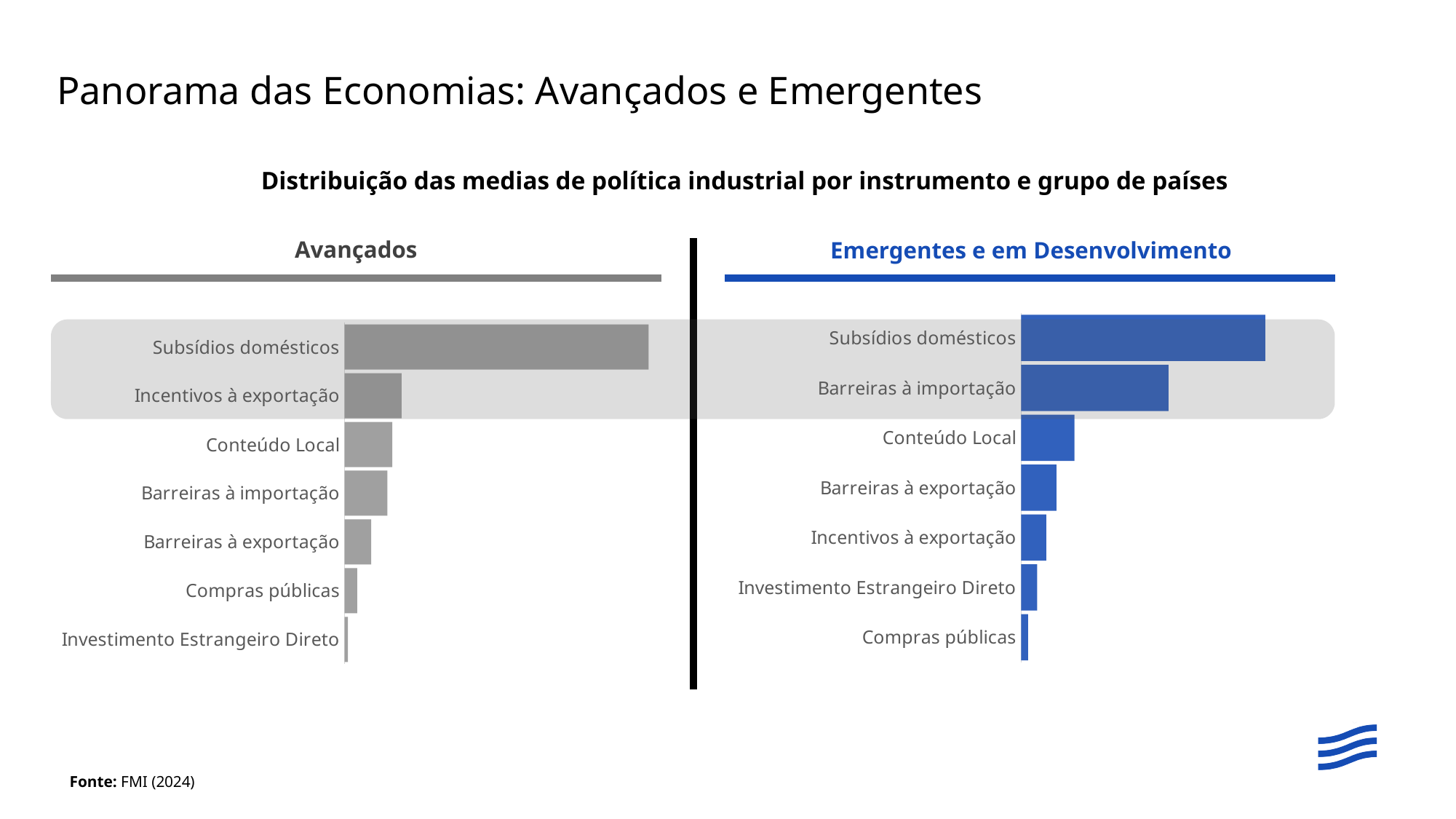
In the Emergentes e em Desenvolvimento chart, which is larger: Barreiras à importação or Conteúdo Local? Barreiras à importação In the Emergentes e em Desenvolvimento chart, which instrument has the highest value? Subsídios domésticos In the Avançados chart, which instrument has the lowest value? Investimento Estrangeiro Direto In the Avançados chart, which is larger: Subsídios domésticos or Incentivos à exportação? Subsídios domésticos In the Avançados chart, which is larger: Barreiras à exportação or Compras públicas? Barreiras à exportação In the Avançados chart, which instrument has the highest value? Subsídios domésticos What source is cited for the charts on the slide? FMI (2024) In the Emergentes e em Desenvolvimento chart, which instrument has the second-highest value? Barreiras à importação What type of chart is used for the Avançados panel? Bar chart In the Emergentes e em Desenvolvimento chart, which instrument has the lowest value? Compras públicas How many instruments are shown in the Avançados chart? 7 How many instruments are shown in the Emergentes e em Desenvolvimento chart? 7